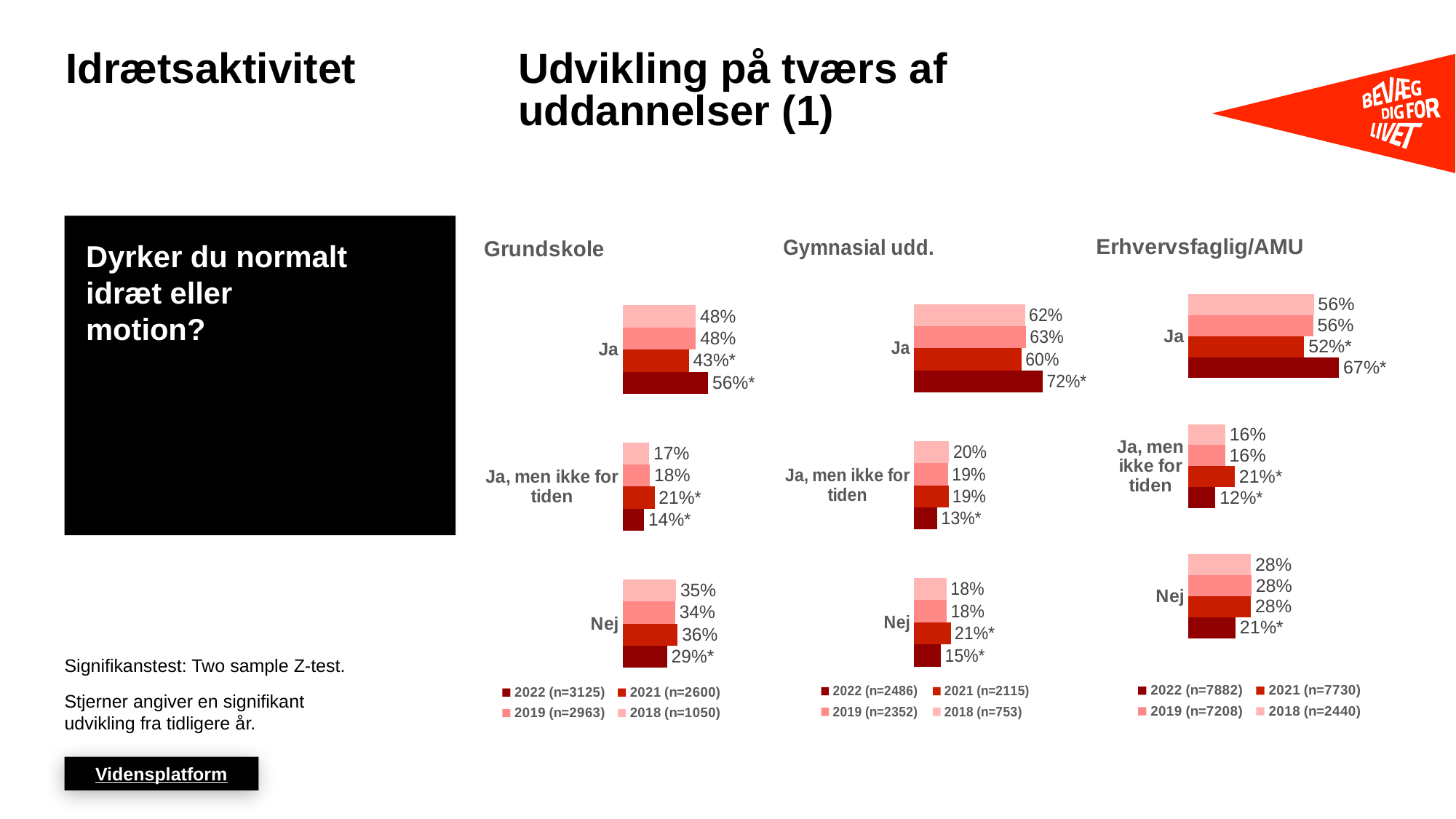
In the Erhvervsfaglig/AMU chart, what is the 2021 value for "Ja, men ikke for tiden"? 21%* How many series does the legend of the Grundskole chart list? 4 How many categories are shown in the Erhvervsfaglig/AMU chart? 3 In the Gymnasial udd. chart, what is the difference between the 2022 and 2021 values for "Ja"? 12 percentage points In the Grundskole chart, what is the 2022 value for "Ja"? 56%* In the Grundskole chart, which year has the lowest value for "Ja, men ikke for tiden"? 2022 In the Erhvervsfaglig/AMU chart, what sample size is given for 2022 in the legend? n=7882 In the Gymnasial udd. chart, what is the 2018 value for "Ja"? 62% In the Erhvervsfaglig/AMU chart, which year has the highest value for "Ja"? 2022 In the Grundskole chart, which is larger for "Nej": the 2021 value or the 2022 value? 2021 What kind of chart is the Gymnasial udd. chart? Bar chart In the Gymnasial udd. chart, what is the 2022 value for "Nej"? 15%*